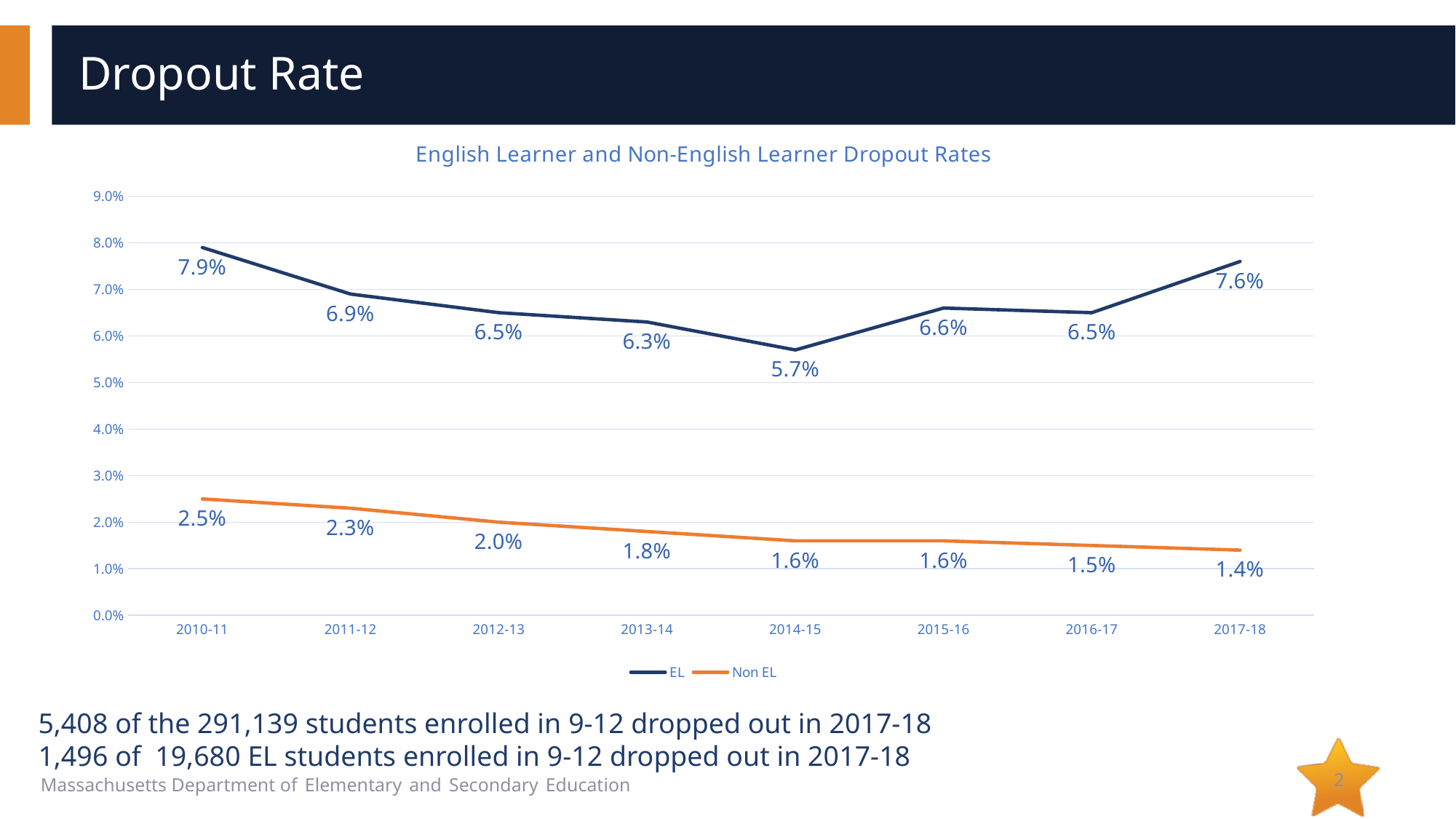
What is the Non EL dropout rate for 2017-18? 1.4% What is the title of the chart? English Learner and Non-English Learner Dropout Rates In which year is the EL dropout rate lowest? 2014-15 Which series has the higher dropout rate in 2013-14, EL or Non EL? EL In which year is the Non EL dropout rate highest? 2010-11 What kind of chart is shown on the slide? Line chart What is the EL dropout rate for 2014-15? 5.7% How many series does the legend list? 2 Does the Non EL dropout rate rise or fall from 2010-11 to 2017-18? Fall What is the difference between the EL and Non EL dropout rates in 2017-18? 6.2% How many school years are shown on the x axis? 8 What is the EL dropout rate for 2010-11? 7.9%